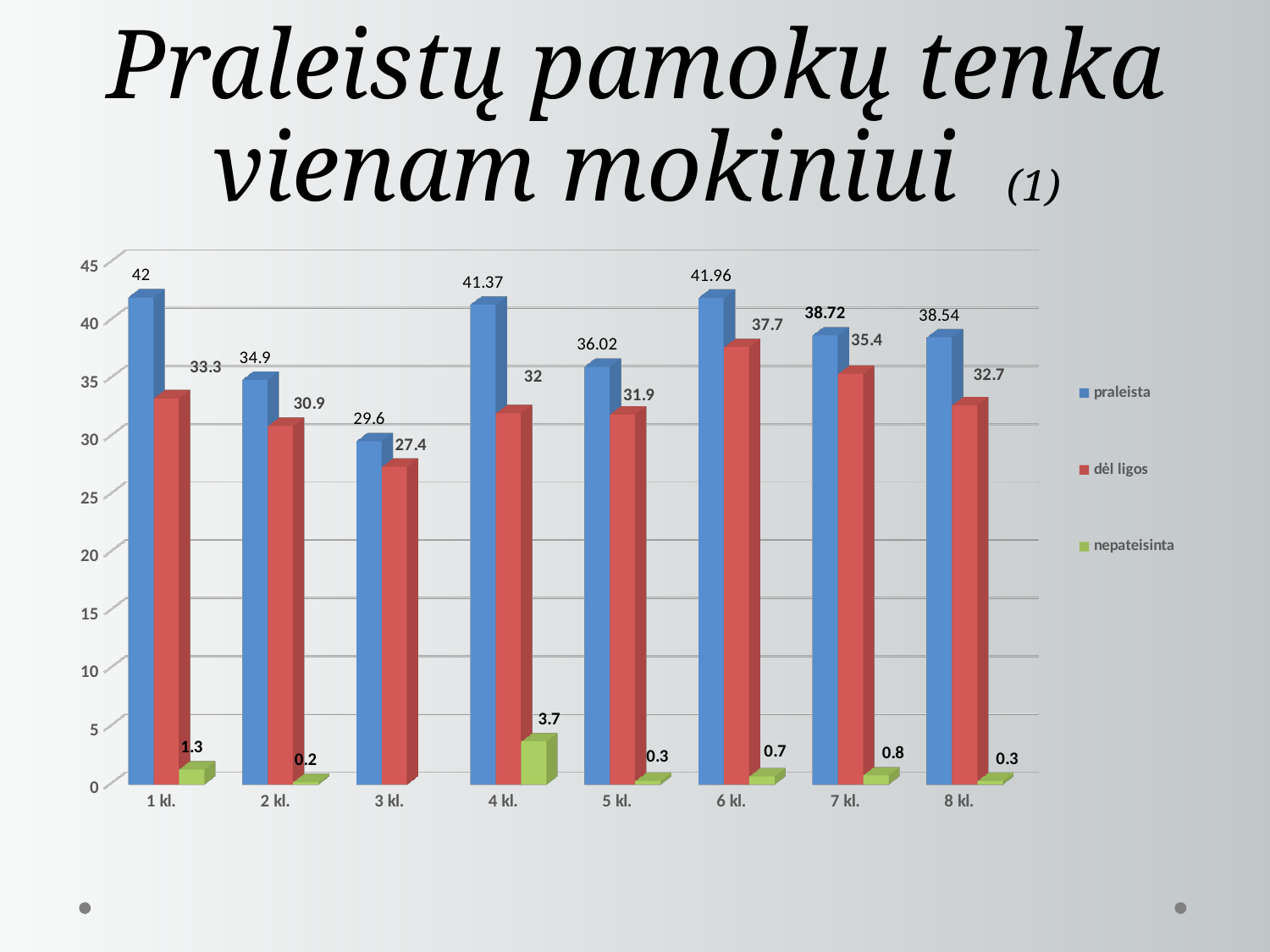
What is the difference between the praleista and dėl ligos values for 1 kl.? 8.7 Which class has the highest dėl ligos value? 6 kl. How many classes are shown on the x axis? 8 What is the dėl ligos value for 6 kl.? 37.7 Which is larger, the dėl ligos value for 7 kl. or for 8 kl.? 7 kl. Which class has the highest nepateisinta value? 4 kl. What is the praleista value for 4 kl.? 41.37 Which class has the lowest praleista value? 3 kl. What is the nepateisinta value for 1 kl.? 1.3 Is the praleista value for 2 kl. greater or less than 40? less How many series does the legend list? 3 What kind of chart is shown on the slide? bar chart